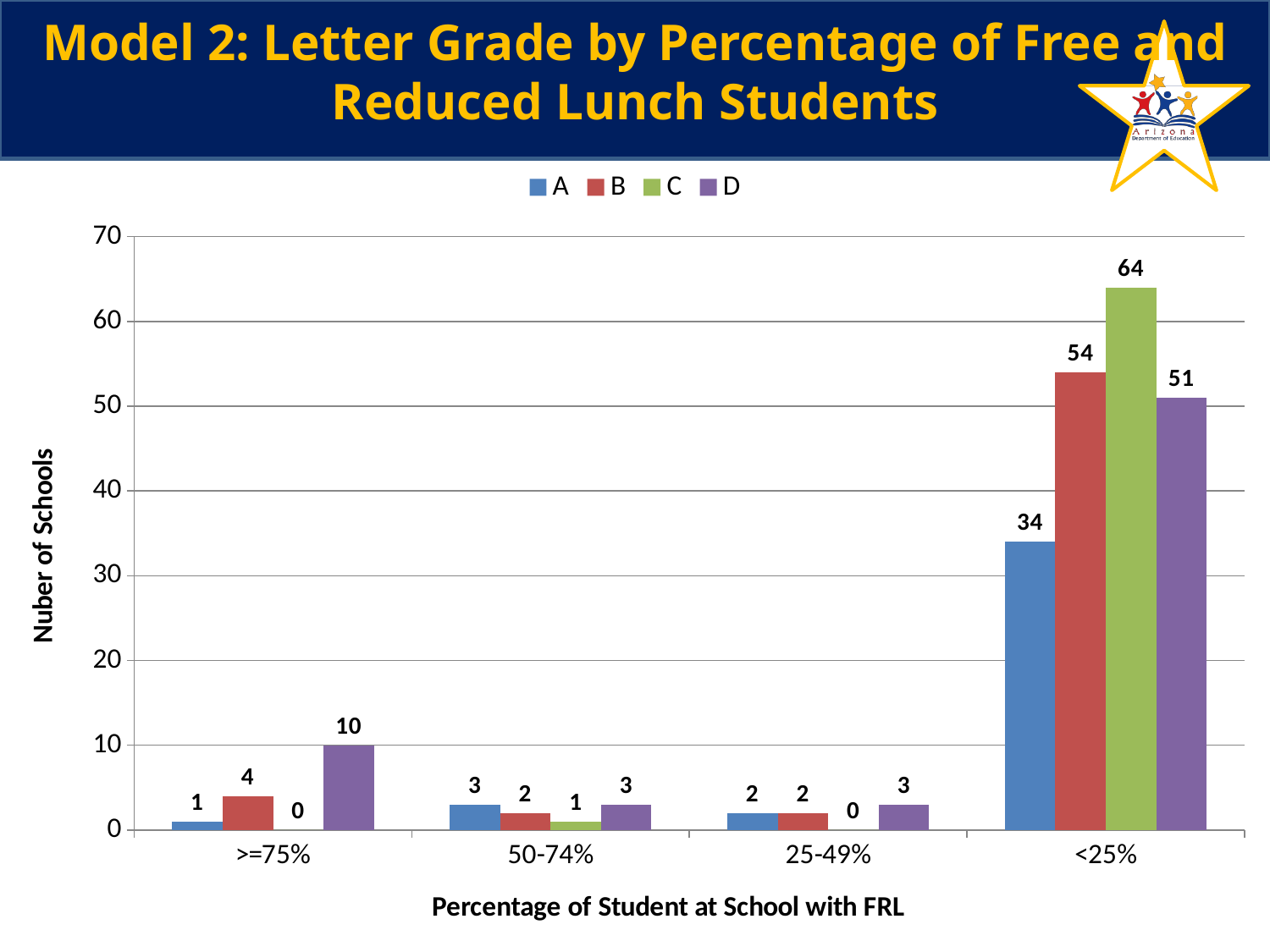
Which grade has the highest value in the <25% category? C What is the value for grade D in the >=75% category? 10 What is the difference between the values for grade B and grade A in the <25% category? 20 How many series does the legend list? 4 Which is larger in the <25% category, the value for grade B or grade D? B What is the label of the y axis? Nuber of Schools How many categories are shown on the x axis? 4 Which grade has the lowest value in the 25-49% category? C Is the value for grade C in the <25% category greater or less than 60? greater What kind of chart is shown on the slide? bar chart What is the value for grade C in the <25% category? 64 What is the value for grade A in the 50-74% category? 3